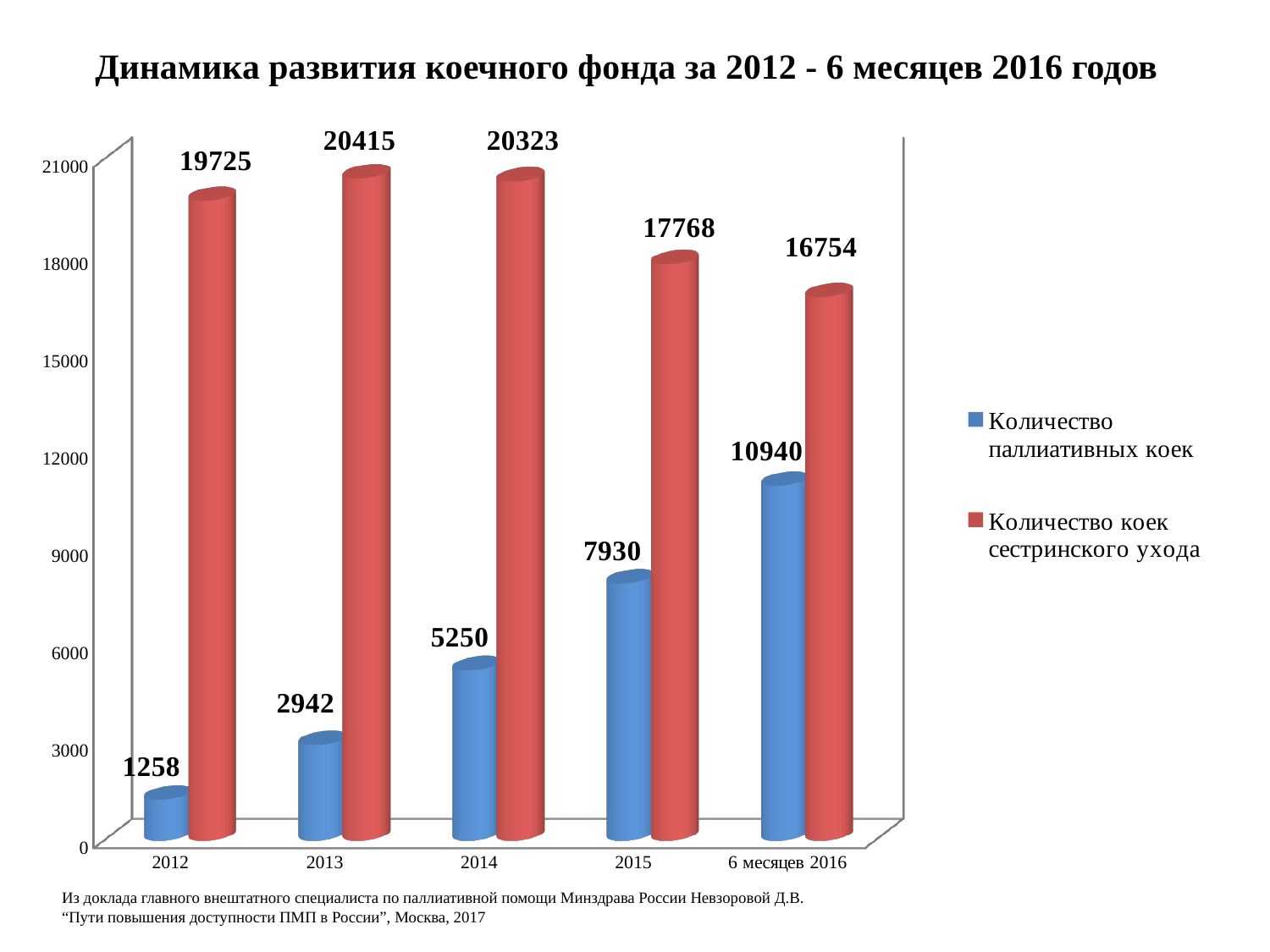
Is the value for Количество коек сестринского ухода in 6 месяцев 2016 greater or less than 18000? less How many categories are shown on the x axis? 5 What kind of chart is shown on the slide? bar chart What is the value for Количество паллиативных коек in 6 месяцев 2016? 10940 Does Количество паллиативных коек rise or fall from 2012 to 6 месяцев 2016? rise What is the value for Количество паллиативных коек in 2012? 1258 What is the value for Количество коек сестринского ухода in 2013? 20415 How many series does the legend list? 2 In which year is Количество паллиативных коек lowest? 2012 What is the difference between Количество коек сестринского ухода and Количество паллиативных коек in 2015? 9838 Which is larger in 2014: Количество паллиативных коек or Количество коек сестринского ухода? Количество коек сестринского ухода In which year is Количество коек сестринского ухода highest? 2013